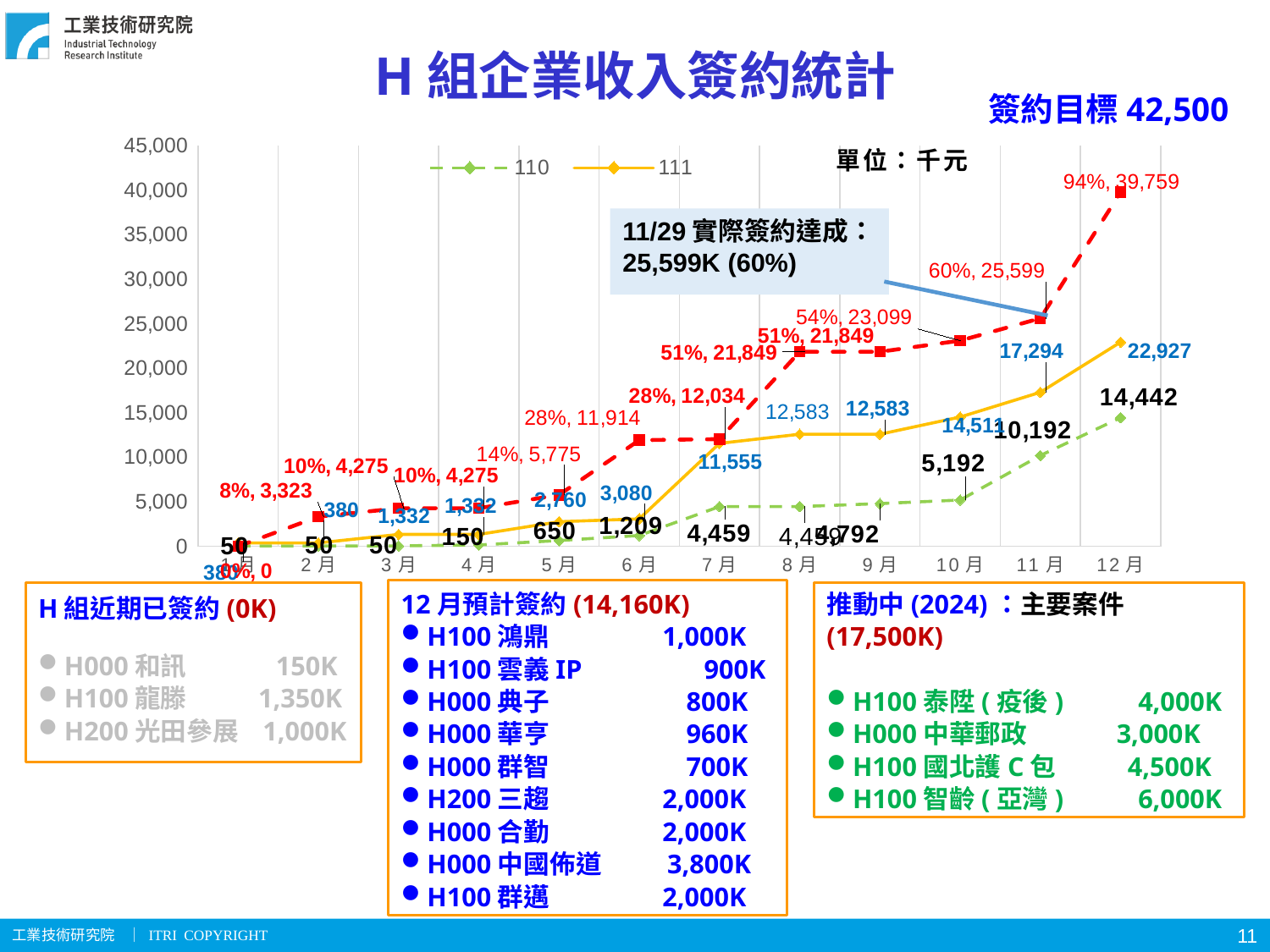
Do the values of series 111 generally rise or fall from 1 月 to 12 月? rise Is the value of series 110 in 11 月 greater or less than 5,000? greater What is the difference between series 111 and series 110 in 12 月? 8,485 Which series has the higher value in 7 月, 110 or 111? 111 How many series does the chart legend list? 2 How many months are shown along the x axis of the chart? 12 What is the value of series 110 in 12 月? 14,442 What kind of chart is shown on the slide? line chart What is the value of series 111 in 12 月? 22,927 What is the value of series 110 in 10 月? 5,192 What is the value of series 111 in 11 月? 17,294 What is the title of the chart? H 組企業收入簽約統計